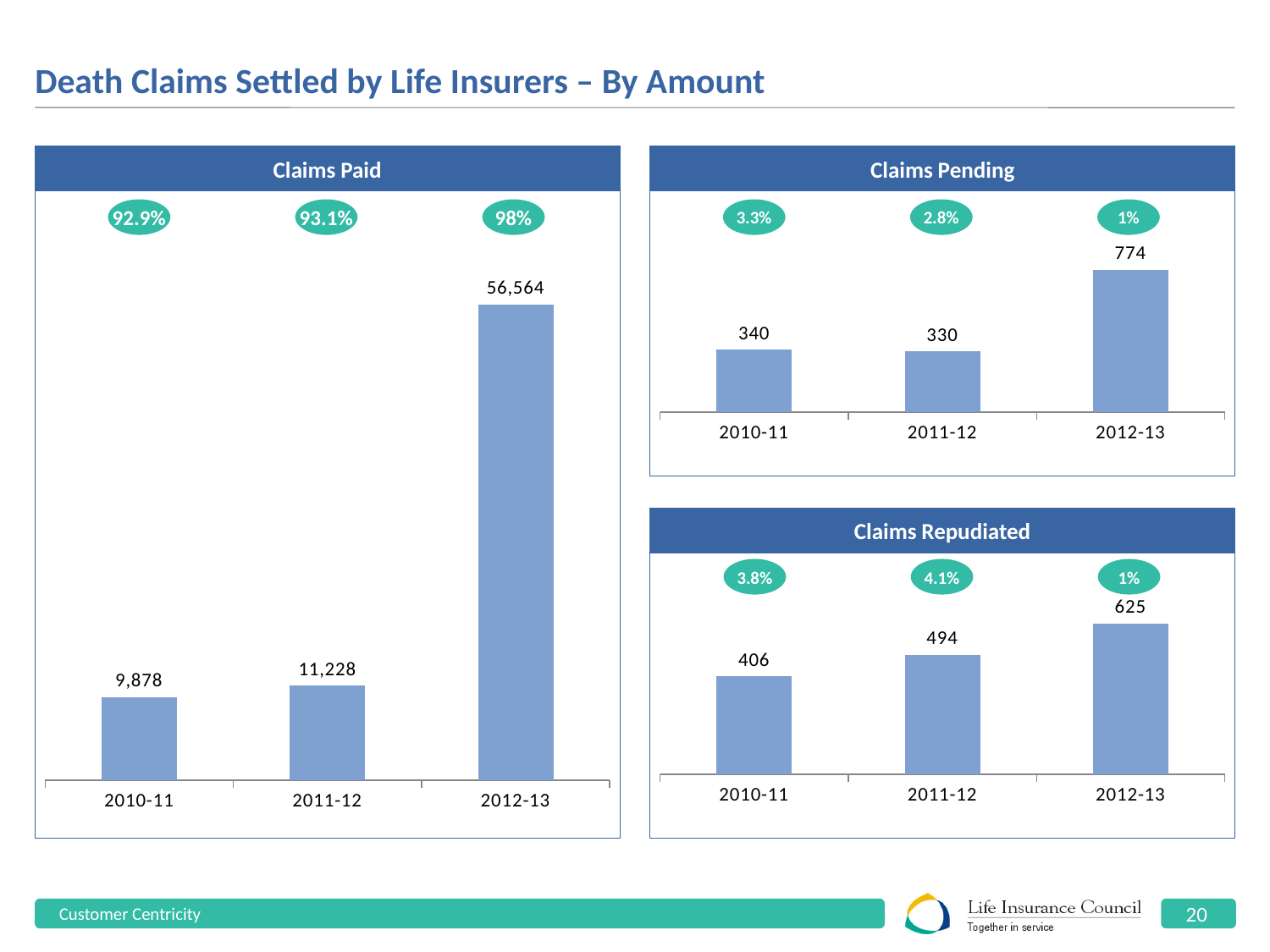
In the Claims Pending chart, which year has the highest value? 2012-13 In the Claims Repudiated chart, do the values rise or fall from 2010-11 to 2012-13? Rise What kind of chart is the Claims Repudiated chart? Bar chart In the Claims Paid chart, what is the difference between the values for 2011-12 and 2010-11? 1,350 How many years are shown in the Claims Paid chart? 3 In the Claims Paid chart, what is the value for 2010-11? 9,878 In the Claims Repudiated chart, which year has the lowest value? 2010-11 In the Claims Paid chart, what is the value for 2012-13? 56,564 In the Claims Pending chart, which is larger, the value for 2010-11 or 2011-12? 2010-11 In the Claims Pending chart, what is the value for 2011-12? 330 In the Claims Repudiated chart, what is the difference between the values for 2012-13 and 2011-12? 131 In the Claims Repudiated chart, what is the value for 2012-13? 625